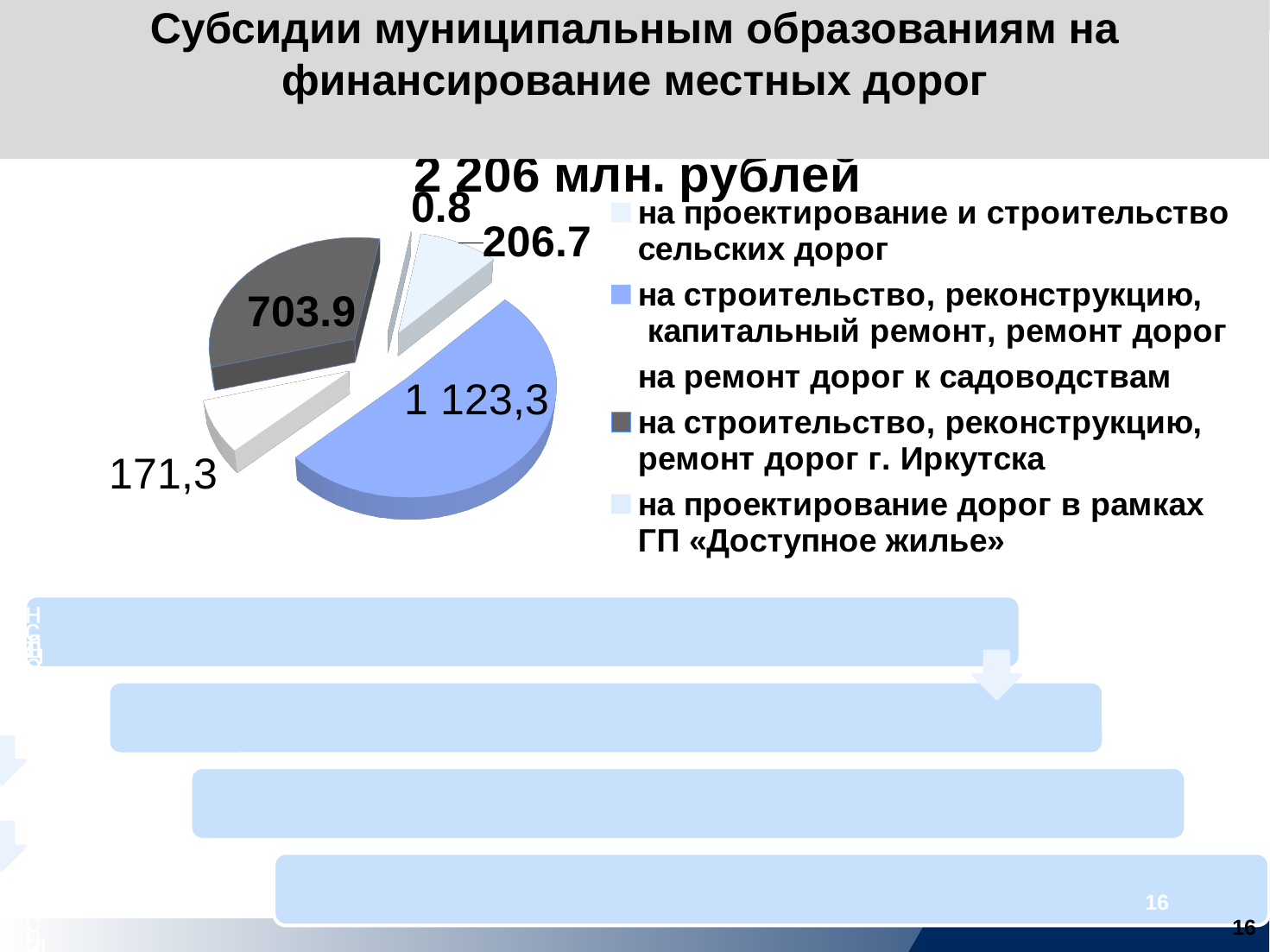
What kind of chart is shown on the slide? pie chart Which category has the largest slice in the pie chart? на строительство, реконструкцию, капитальный ремонт, ремонт дорог What value is shown for 'на проектирование и строительство сельских дорог'? 206.7 Which is larger: the slice for 'на ремонт дорог к садоводствам' or the slice for 'на проектирование и строительство сельских дорог'? на проектирование и строительство сельских дорог What value is shown for 'на ремонт дорог к садоводствам'? 171,3 What value is shown for 'на строительство, реконструкцию, ремонт дорог г. Иркутска'? 703.9 What is the difference between the value for roads of Irkutsk (703.9) and the value for rural roads (206.7)? 497.2 What value is shown for 'на строительство, реконструкцию, капитальный ремонт, ремонт дорог'? 1 123,3 What total amount is stated in the title above the pie chart? 2 206 млн. рублей How many entries does the legend of the pie chart list? 5 How many slices does the pie chart have? 5 Which category has the smallest slice in the pie chart? на проектирование дорог в рамках ГП «Доступное жилье»